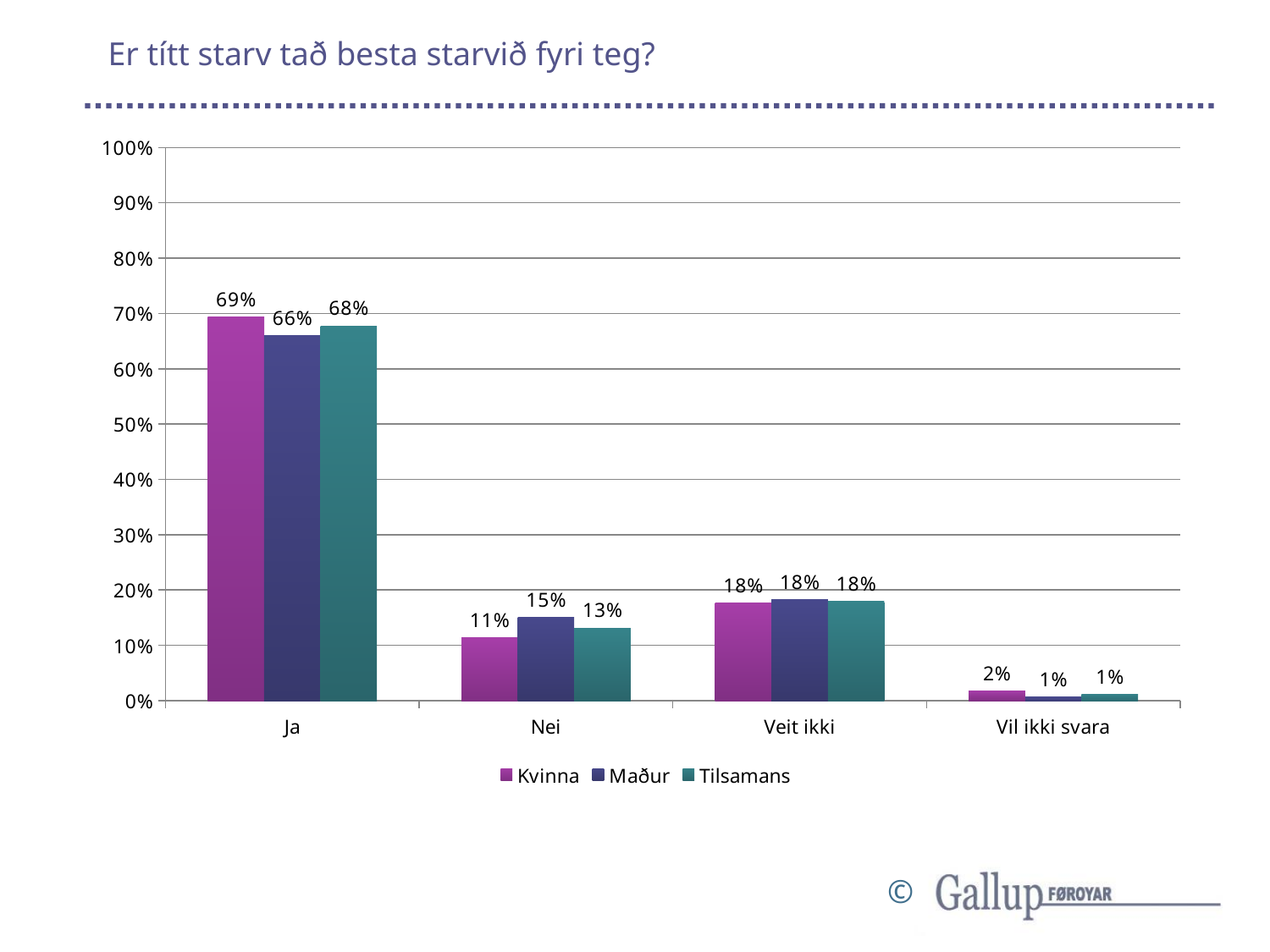
How many series does the legend list? 3 How many categories are shown on the x axis? 4 Which category has the highest value for Tilsamans? Ja What is the title of the slide? Er títt starv tað besta starvið fyri teg? What is the difference between the Kvinna and Maður values in the Ja category? 3% What kind of chart is shown on the slide? bar chart What is the value for Maður in the Nei category? 15% What is the value for Kvinna in the Ja category? 69% Which category has the lowest value for Kvinna? Vil ikki svara In the Nei category, which is larger: Kvinna or Maður? Maður What is the value for Tilsamans in the Vil ikki svara category? 1% Is the value for Tilsamans in the Ja category greater or less than 60%? greater